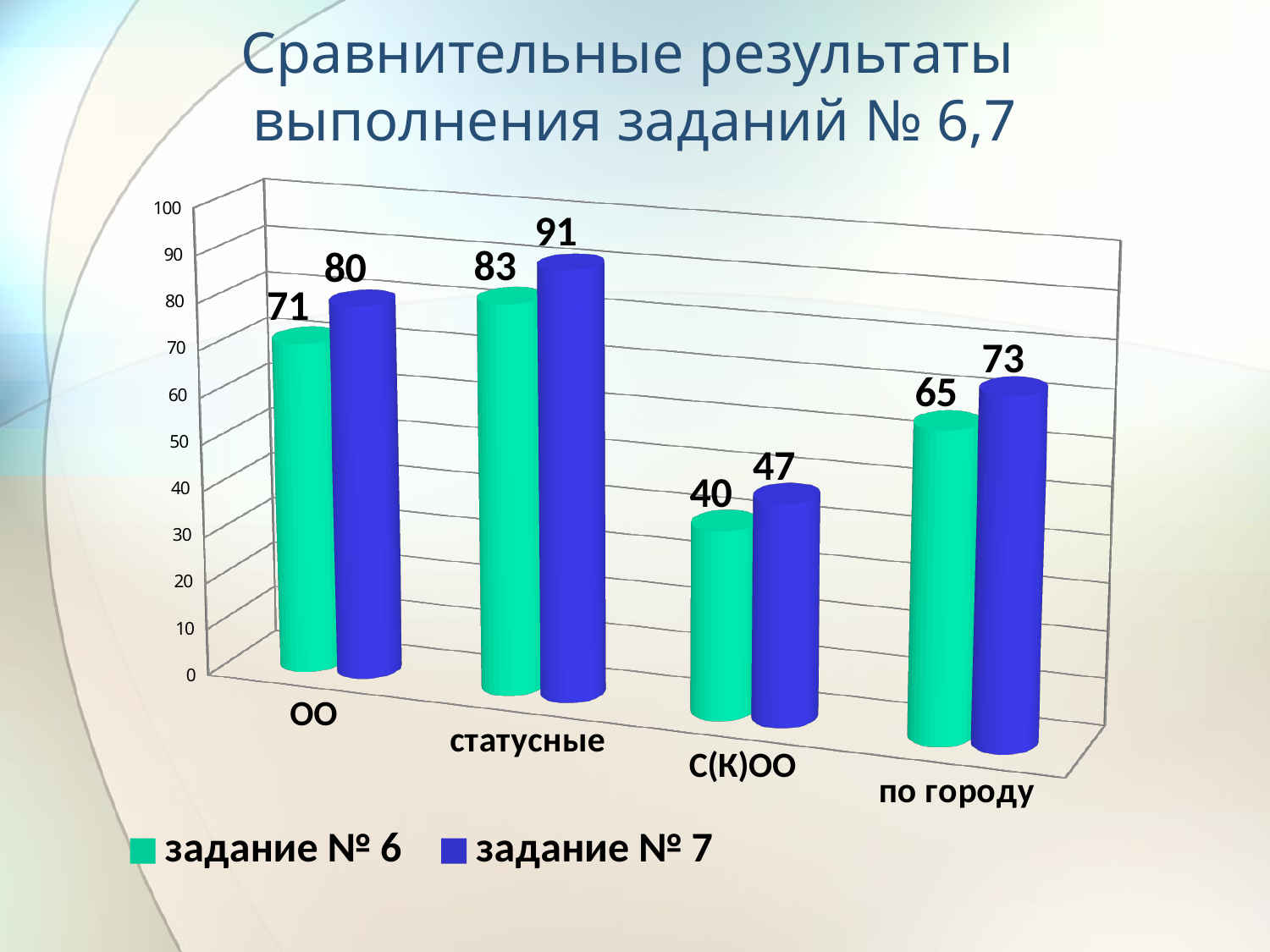
What is the value for задание № 6 in the С(К)ОО category? 40 What is the value for задание № 7 in the статусные category? 91 Which category has the highest value for задание № 7? статусные Which is larger in the по городу category: задание № 6 or задание № 7? задание № 7 What colour are the bars for задание № 7? blue How many categories are shown on the x axis? 4 What is the value for задание № 6 in the ОО category? 71 What is the difference between задание № 7 and задание № 6 in the ОО category? 9 What is the value for задание № 7 in the по городу category? 73 What kind of chart is shown on the slide? bar chart Which category has the lowest value for задание № 6? С(К)ОО How many series does the legend list? 2